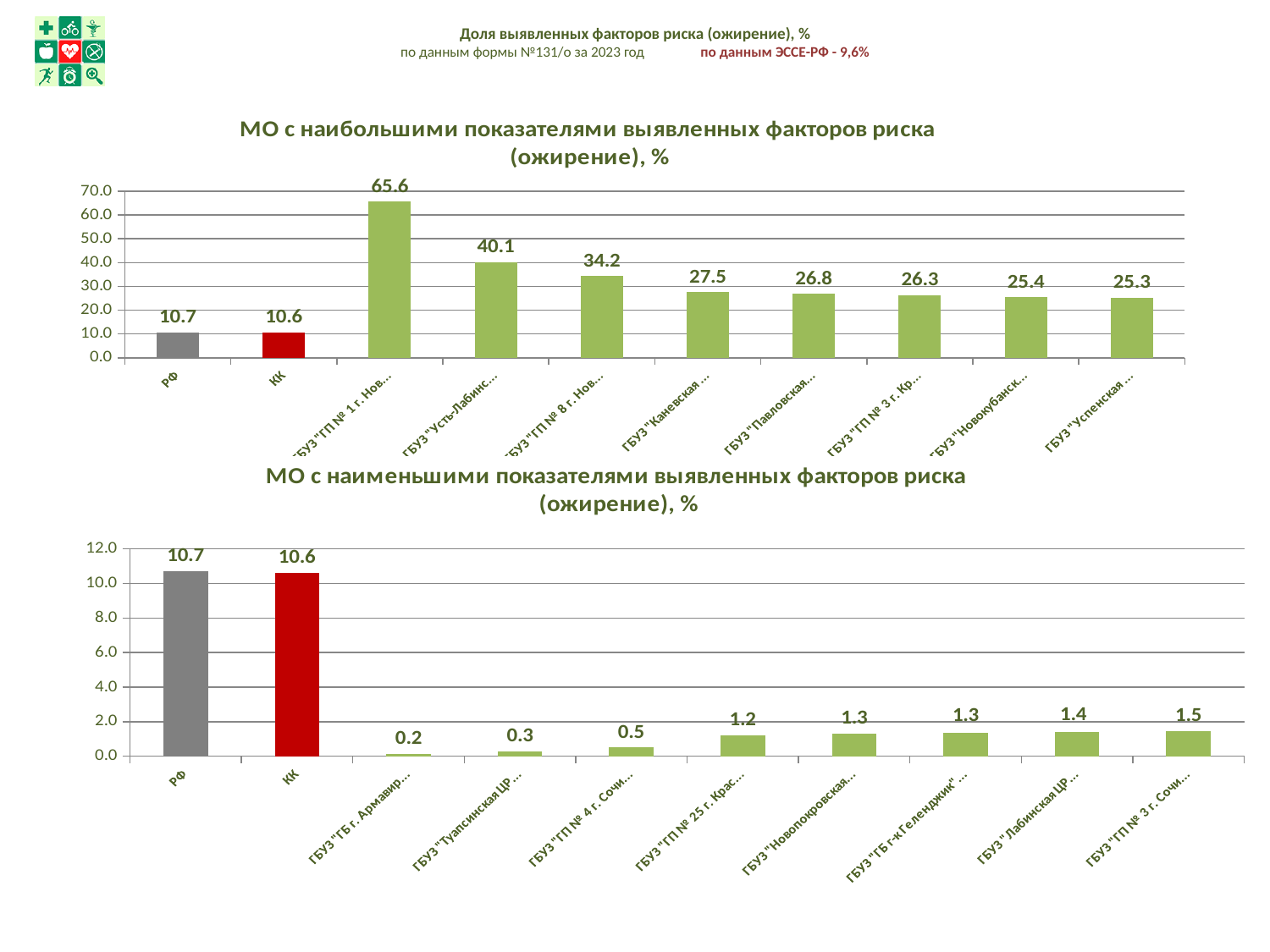
What type of chart is the top chart (МО с наибольшими показателями)? Bar chart In the bottom chart (МО с наименьшими показателями), what is the value for ГБУЗ "ГБ г. Армавир..."? 0.2 In the top chart (МО с наибольшими показателями), what is the difference between the highest bar (65.6) and the value for КК (10.6)? 55.0 In the bottom chart (МО с наименьшими показателями), what is the value for ГБУЗ "ГП № 3 г. Сочи..."? 1.5 In the top chart (МО с наибольшими показателями), how many bars are plotted? 10 In the top chart (МО с наибольшими показателями), what is the value for ГБУЗ "Каневская ..."? 27.5 In the top chart (МО с наибольшими показателями), what is the value for КК? 10.6 In the bottom chart (МО с наименьшими показателями), which is larger: the value for РФ or the value for ГБУЗ "Лабинская ЦР..."? РФ In the bottom chart (МО с наименьшими показателями), what is the difference between the values for РФ and КК? 0.1 In the top chart (МО с наибольшими показателями), what is the value for РФ? 10.7 In the top chart (МО с наибольшими показателями), what is the highest value shown? 65.6 In the bottom chart (МО с наименьшими показателями), what is the lowest value shown? 0.2